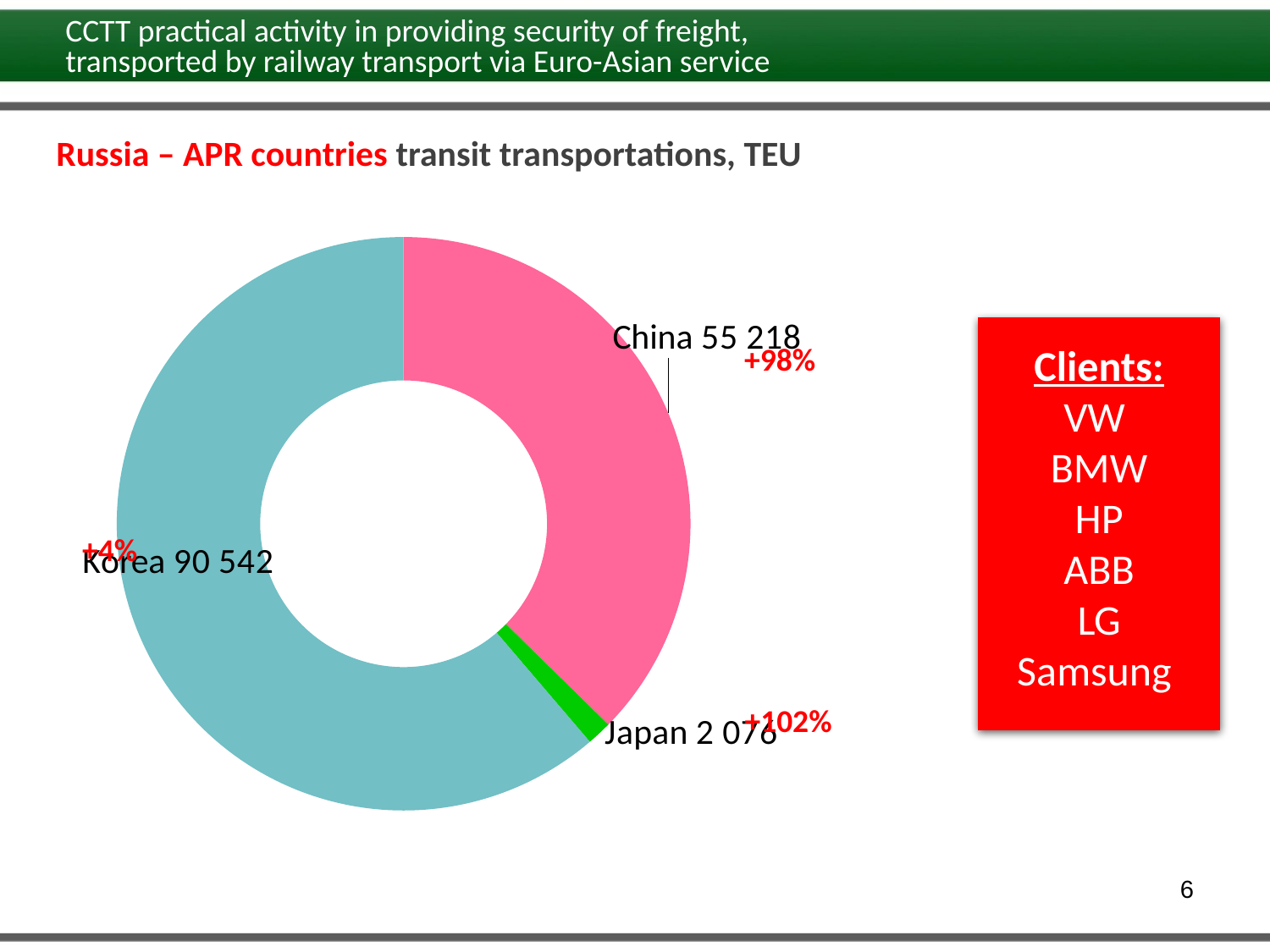
What is the total of the three values shown in the chart? 147 836 Which is larger, the value for China or the value for Japan? China Which country has the smallest slice in the chart? Japan What growth percentage is shown next to China in the chart? +98% How many countries are shown in the chart? 3 What is the value for Japan in the chart? 2 076 What is the difference between the values for Korea and China? 35 324 What growth percentage is shown next to Japan in the chart? +102% What is the value for China in the Russia – APR countries transit transportations chart? 55 218 Which country has the largest slice in the chart? Korea What kind of chart is shown on the slide? Doughnut (pie) chart What is the value for Korea in the chart? 90 542